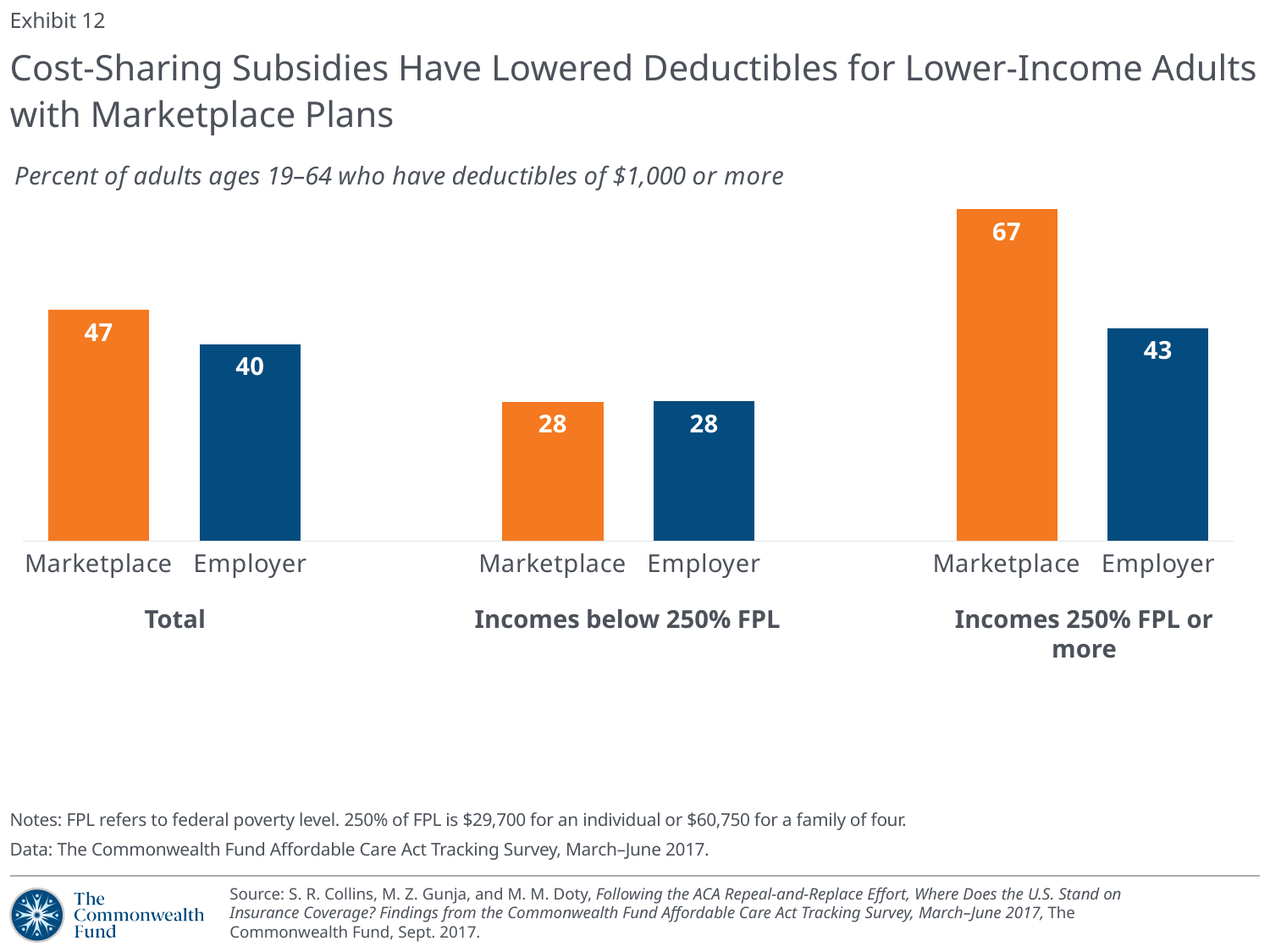
Which bar has the highest value on the chart? Marketplace, Incomes 250% FPL or more What is the value for Employer in the Incomes 250% FPL or more group? 43 What kind of chart is shown on the slide? Bar chart In the Incomes below 250% FPL group, is the Marketplace value larger than, smaller than, or equal to the Employer value? equal How many income groups are shown on the chart? 3 What is the value for Marketplace in the Incomes below 250% FPL group? 28 What is the value for Marketplace in the Total group? 47 In the Incomes 250% FPL or more group, which is larger: Marketplace or Employer? Marketplace What does the chart subtitle say is being measured? Percent of adults ages 19–64 who have deductibles of $1,000 or more How many bars are plotted on the chart in total? 6 What is the difference between the Marketplace and Employer values in the Incomes 250% FPL or more group? 24 What is the difference between the Marketplace and Employer values in the Total group? 7